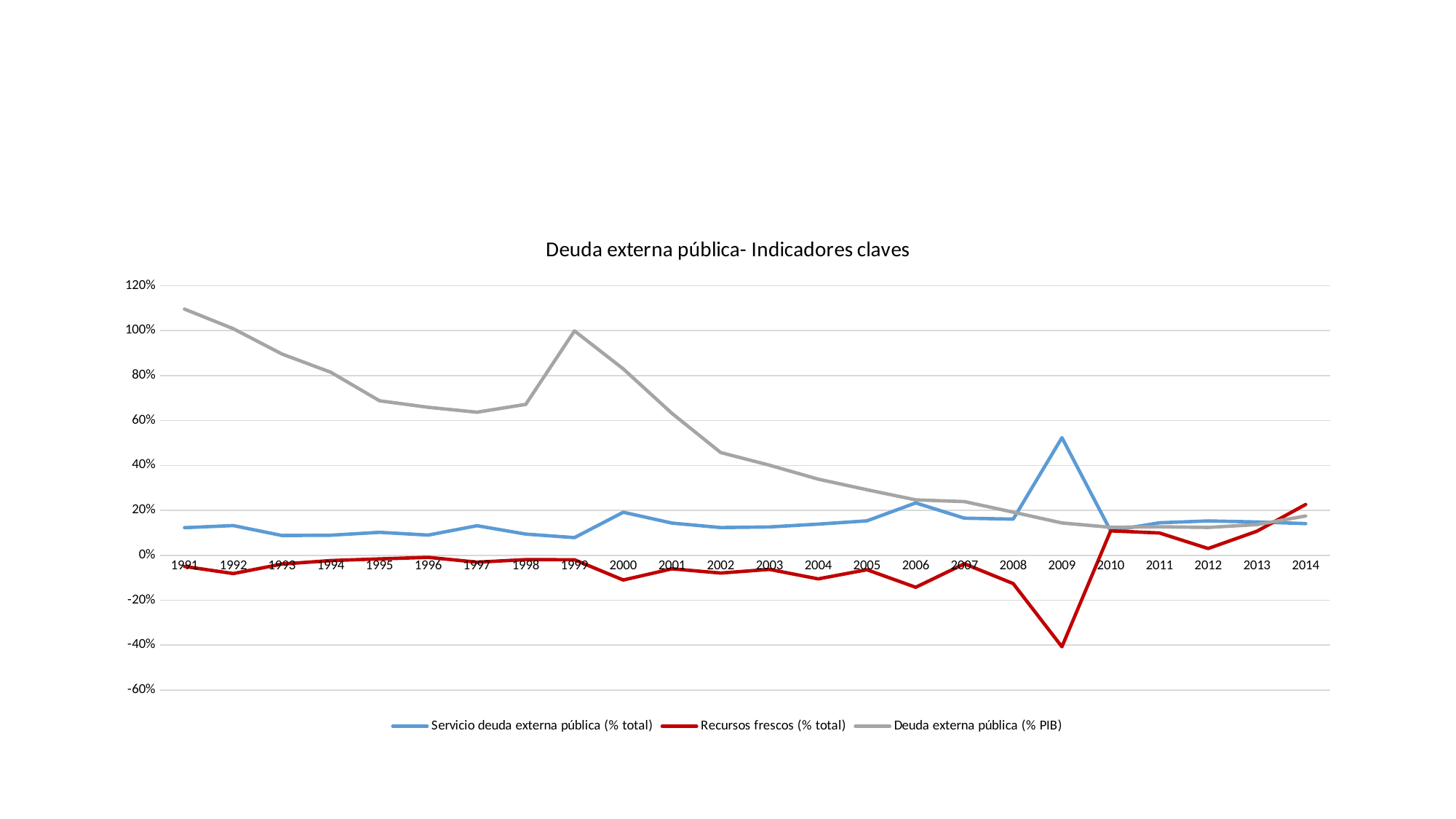
In which year is Deuda externa pública (% PIB) highest? 1991 What kind of chart is shown on the slide? line chart Does Deuda externa pública (% PIB) overall rise or fall from 1991 to 2014? fall How many series does the legend list? 3 How many years are plotted along the x axis? 24 Is the value for Recursos frescos (% total) in 2009 greater or less than -20%? less Is the value for Deuda externa pública (% PIB) in 1991 greater or less than 100%? greater In which year is Recursos frescos (% total) highest? 2014 In which year is Servicio deuda externa pública (% total) highest? 2009 What is the title of the chart? Deuda externa pública- Indicadores claves In which year is Recursos frescos (% total) lowest? 2009 Which series is drawn in red? Recursos frescos (% total)